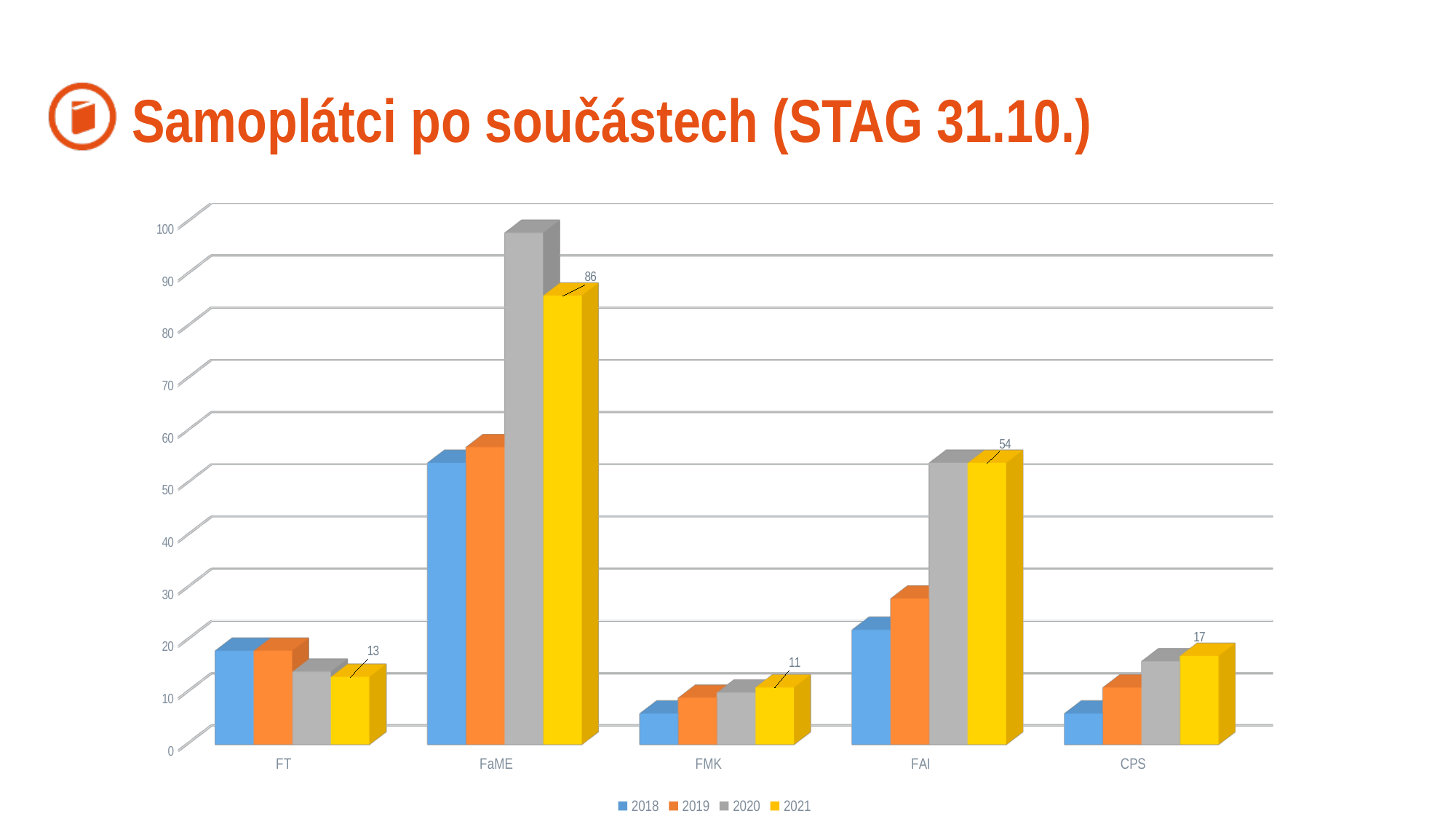
How many categories are shown on the x axis? 5 What is the value for FAI in the 2021 series? 54 What kind of chart is shown on the slide? bar chart How many series does the legend list? 4 What is the value for FaME in the 2021 series? 86 What is the difference between the 2021 values for FaME and FAI? 32 What is the value for FT in the 2021 series? 13 Which is larger in the 2021 series, FAI or CPS? FAI Is the value for FaME in the 2020 series greater or less than 90? greater What is the value for CPS in the 2021 series? 17 Which category has the lowest value in the 2021 series? FMK Which category has the highest value in the 2021 series? FaME